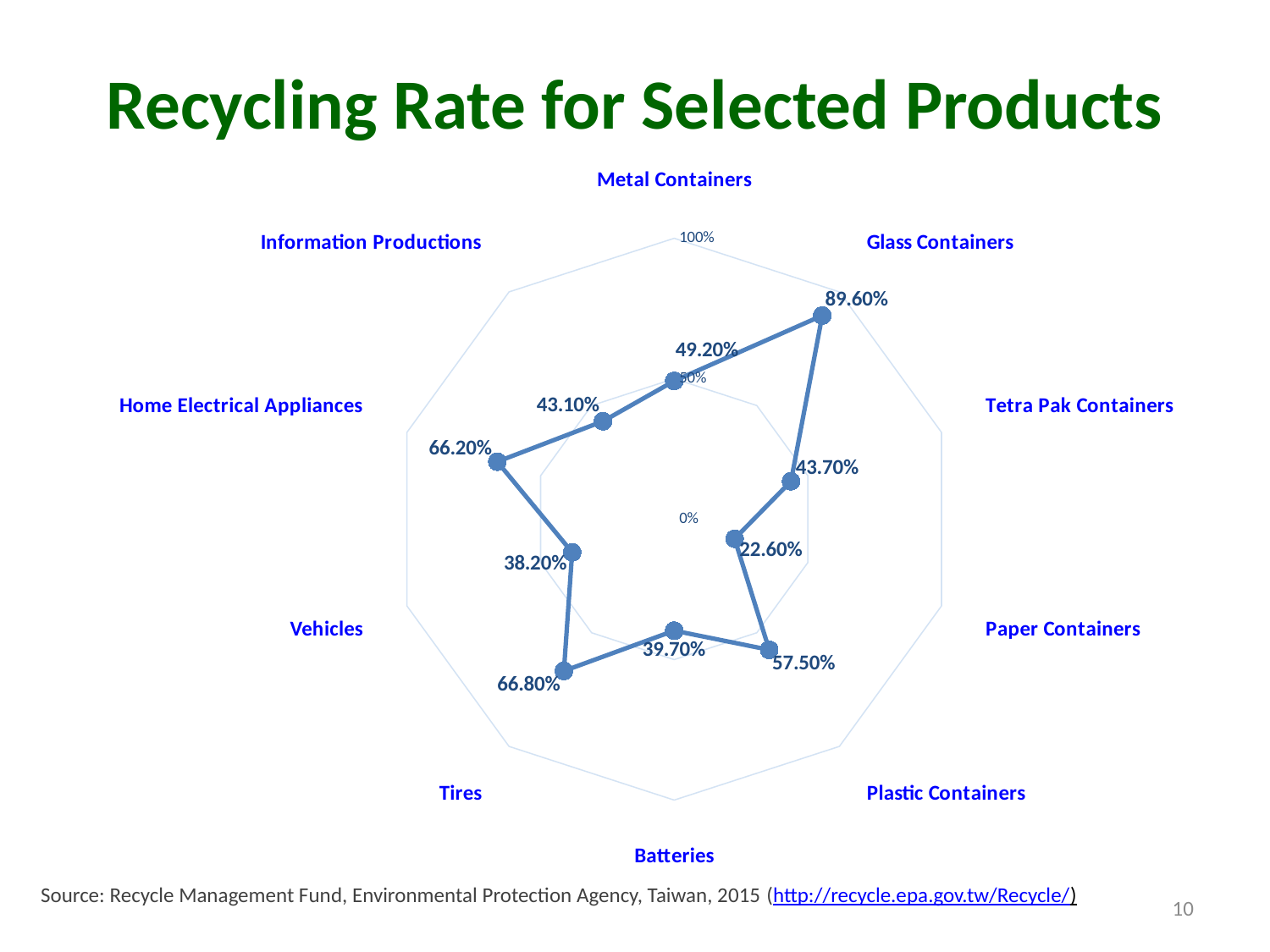
Which product has the highest recycling rate? Glass Containers How many products are shown on the chart? 10 What is the difference between the recycling rates of Glass Containers and Paper Containers? 67.00% What is the recycling rate for Paper Containers? 22.60% What is the title of the chart? Recycling Rate for Selected Products What is the recycling rate for Batteries? 39.70% What is the recycling rate for Tires? 66.80% What is the recycling rate for Metal Containers? 49.20% What is the recycling rate for Glass Containers? 89.60% Which product has the lowest recycling rate? Paper Containers Which has a higher recycling rate, Plastic Containers or Tetra Pak Containers? Plastic Containers What kind of chart is shown on the slide? Radar chart